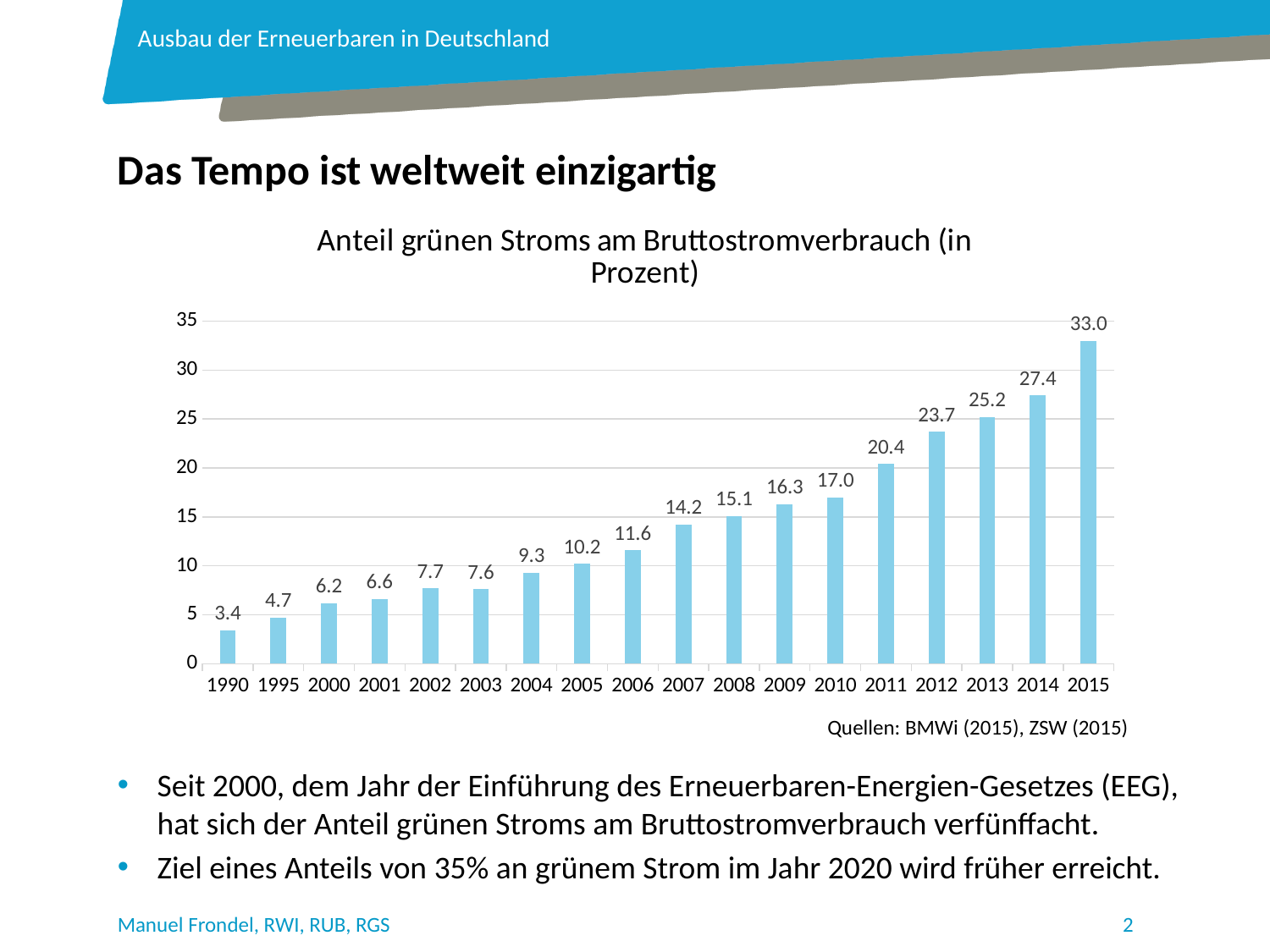
Which year has the lowest value? 1990 What is the value for 2015? 33.0 Which year has the highest value? 2015 Is the value for 2011 greater or less than 20? greater What kind of chart is this? bar chart Do the values generally rise or fall from 1990 to 2015? rise What is the value for 2010? 17.0 How many years are shown on the x axis? 18 Which is larger, the value for 2002 or the value for 2003? 2002 What is the difference between the values for 2015 and 2014? 5.6 What is the value for 2000? 6.2 What is the title of the chart? Anteil grünen Stroms am Bruttostromverbrauch (in Prozent)